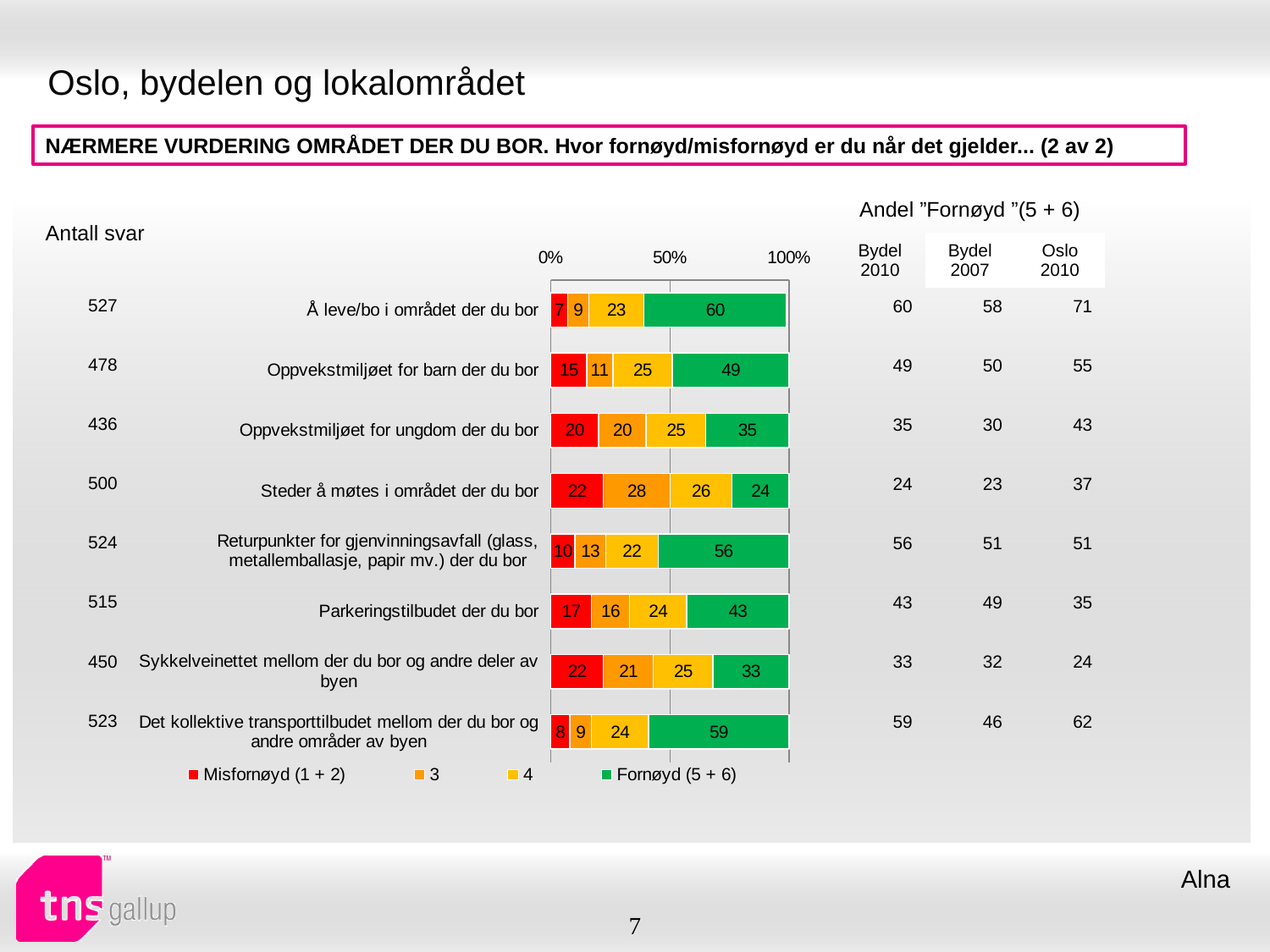
How many series does the legend list? 4 What is the value of series "4" for "Parkeringstilbudet der du bor"? 24 Which category has the highest Fornøyd (5 + 6) value? Å leve/bo i området der du bor What is the total of the stacked bar for "Sykkelveinettet mellom der du bor og andre deler av byen"? 101 Which has the larger Misfornøyd (1 + 2) value: "Oppvekstmiljøet for ungdom der du bor" or "Parkeringstilbudet der du bor"? Oppvekstmiljøet for ungdom der du bor What is the Misfornøyd (1 + 2) value for "Steder å møtes i området der du bor"? 22 Which colour represents the Fornøyd (5 + 6) series in the chart? Green How many categories are shown in the bar chart? 8 Which category has the lowest Fornøyd (5 + 6) value? Steder å møtes i området der du bor What is the difference between the Fornøyd (5 + 6) values for "Oppvekstmiljøet for barn der du bor" and "Oppvekstmiljøet for ungdom der du bor"? 14 What kind of chart is shown on the slide? Stacked bar chart What is the Fornøyd (5 + 6) value for "Å leve/bo i området der du bor"? 60